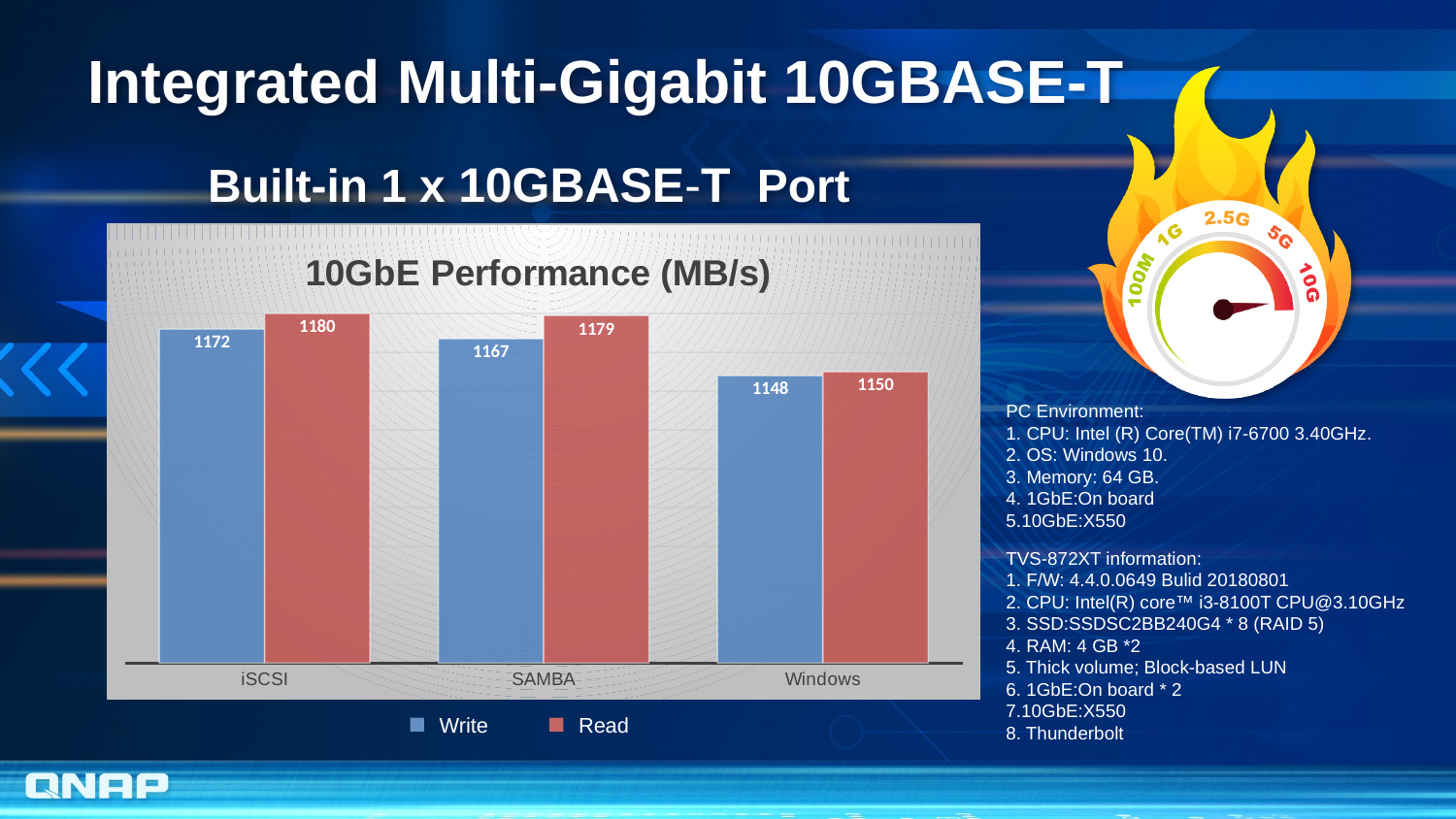
Which category has the highest Read value? iSCSI What is the Write value for iSCSI? 1172 What is the Write value for Windows? 1148 How many series does the legend list? 2 What is the Read value for SAMBA? 1179 What is the difference between the iSCSI Write value and the Windows Write value? 24 How many categories are shown on the x axis? 3 What is the difference between the Read and Write values for SAMBA? 12 Which is larger, the Write value for iSCSI or the Write value for SAMBA? iSCSI What is the title of the chart? 10GbE Performance (MB/s) Which category has the lowest Write value? Windows What is the Read value for Windows? 1150